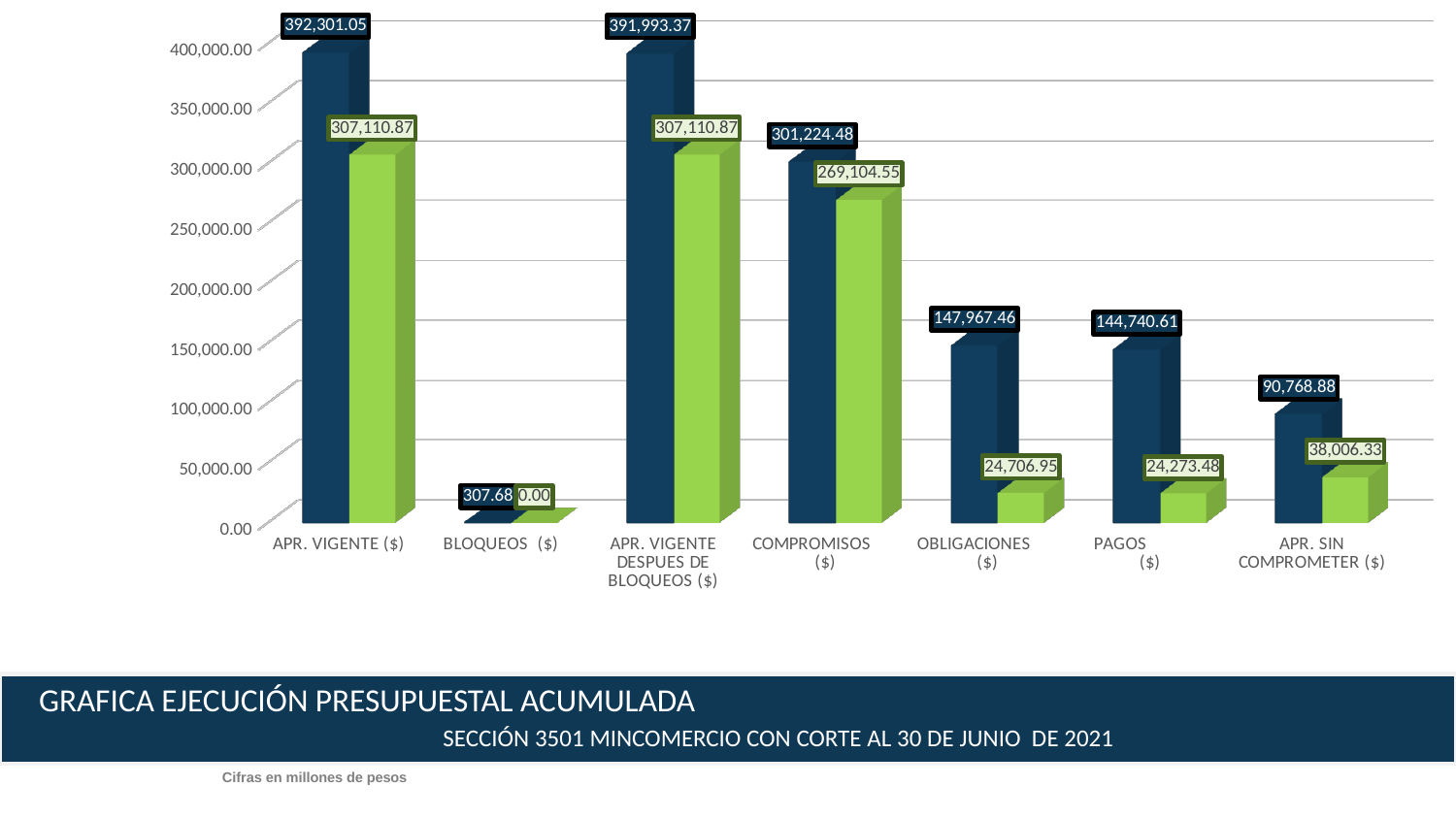
How many categories are shown on the x axis? 7 What is the value of the dark blue bar for APR. VIGENTE ($)? 392,301.05 What is the difference between the dark blue and green bars for APR. VIGENTE ($)? 85,190.18 What is the difference between the dark blue bars for OBLIGACIONES ($) and PAGOS ($)? 3,226.85 Which category has the highest dark blue bar? APR. VIGENTE ($) What is the value of the green bar for COMPROMISOS ($)? 269,104.55 Which category has the lowest green bar? BLOQUEOS ($) Which is larger, the green bar for APR. SIN COMPROMETER ($) or the green bar for OBLIGACIONES ($)? APR. SIN COMPROMETER ($) What type of chart is shown on the slide? Bar chart Is the dark blue bar for COMPROMISOS ($) greater or less than 300,000.00? greater What is the value of the green bar for BLOQUEOS ($)? 0.00 What is the value of the dark blue bar for PAGOS ($)? 144,740.61